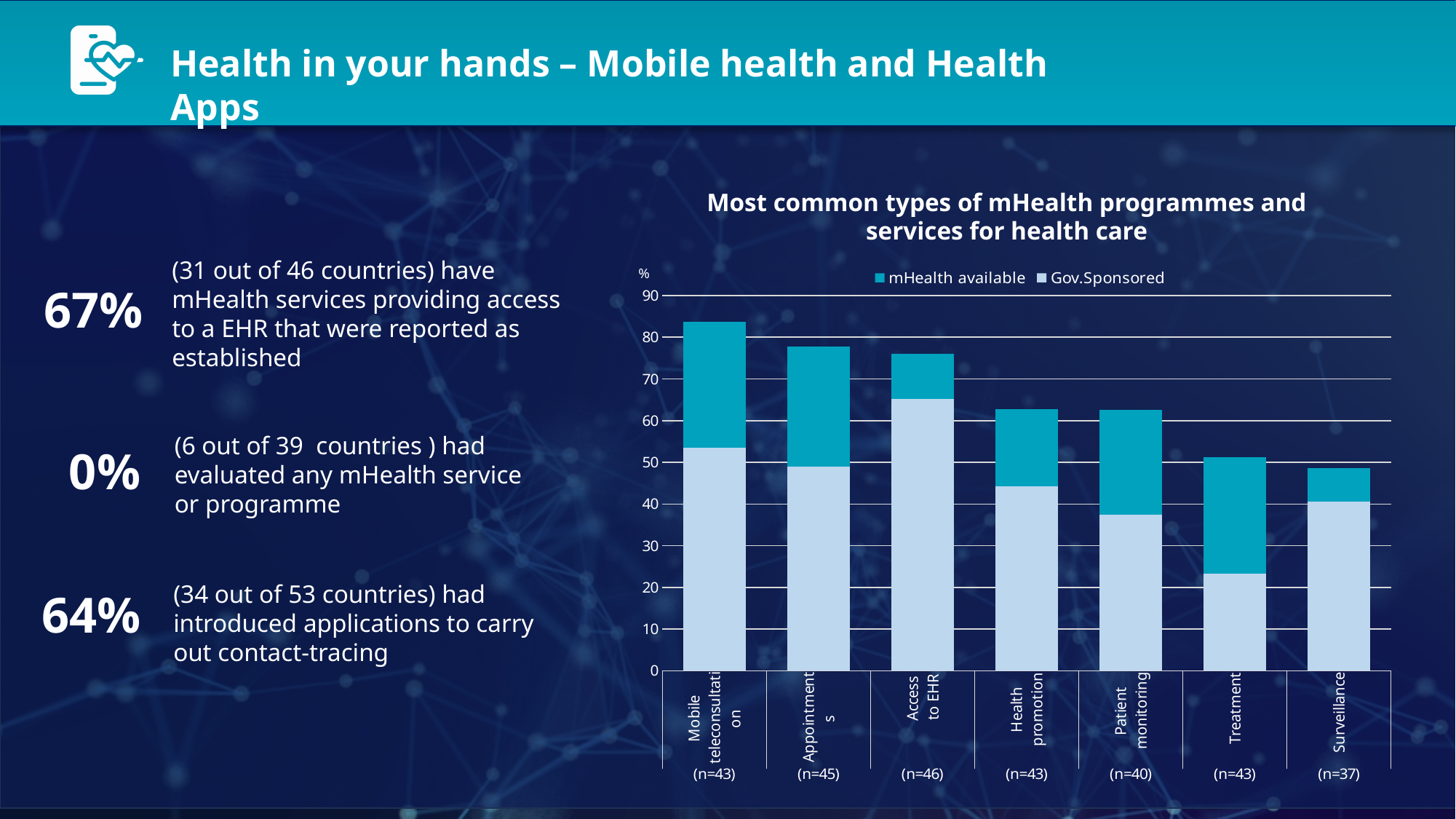
Is the overall bar height for Mobile teleconsultation greater or less than 80? greater Which category has the tallest overall bar in the chart? Mobile teleconsultation Which category has the highest Gov.Sponsored value? Access to EHR Which category has the lowest Gov.Sponsored value? Treatment Is the Gov.Sponsored value for Treatment greater or less than 30? less Do the overall bar heights rise or fall moving from left to right along the x axis? fall How many series does the chart legend list? 2 What is the title of the chart? Most common types of mHealth programmes and services for health care Is the Gov.Sponsored value for Access to EHR greater or less than 60? greater How many categories are shown on the x axis of the chart? 7 Which series is shown in the darker teal colour in the chart? mHealth available What kind of chart is shown on the slide? Stacked bar chart